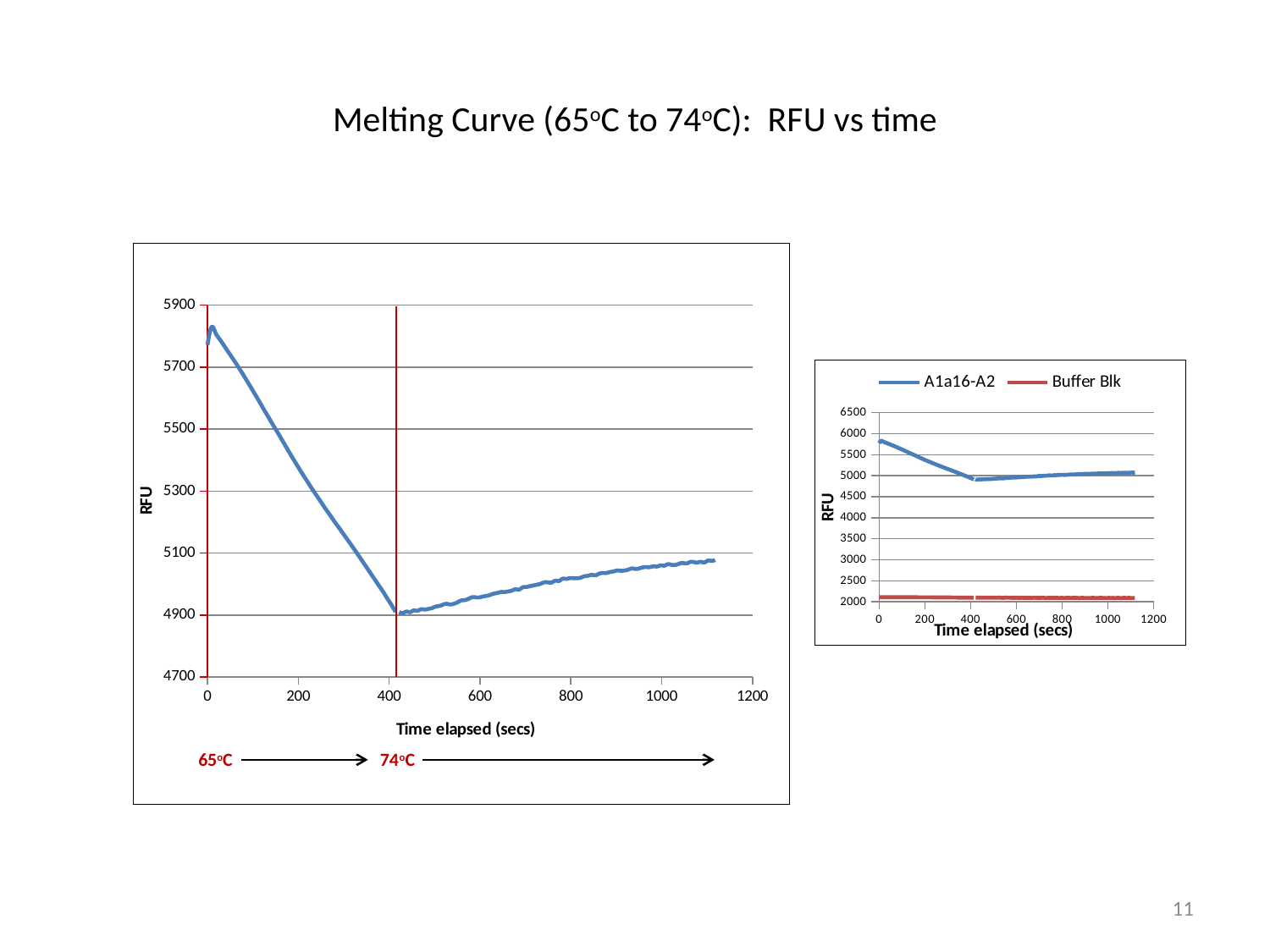
In the large chart on the left, is the RFU value at 1000 seconds greater or less than 4900? greater In the large chart on the left, does the RFU value rise or fall between 600 and 1000 seconds? rise What kind of chart is the large chart on the left of the slide? line chart In the small chart on the right, is the value of Buffer Blk greater or less than 2500? less In the large chart on the left, is the RFU value at 0 seconds greater or less than 5700? greater What is the x-axis title of the large chart on the left? Time elapsed (secs) How many series does the legend of the small chart on the right list? 2 In the small chart on the right, which series is higher, A1a16-A2 or Buffer Blk? A1a16-A2 What kind of chart is the small chart on the right of the slide? line chart In the large chart on the left, does the RFU value rise or fall between 0 and 400 seconds? fall